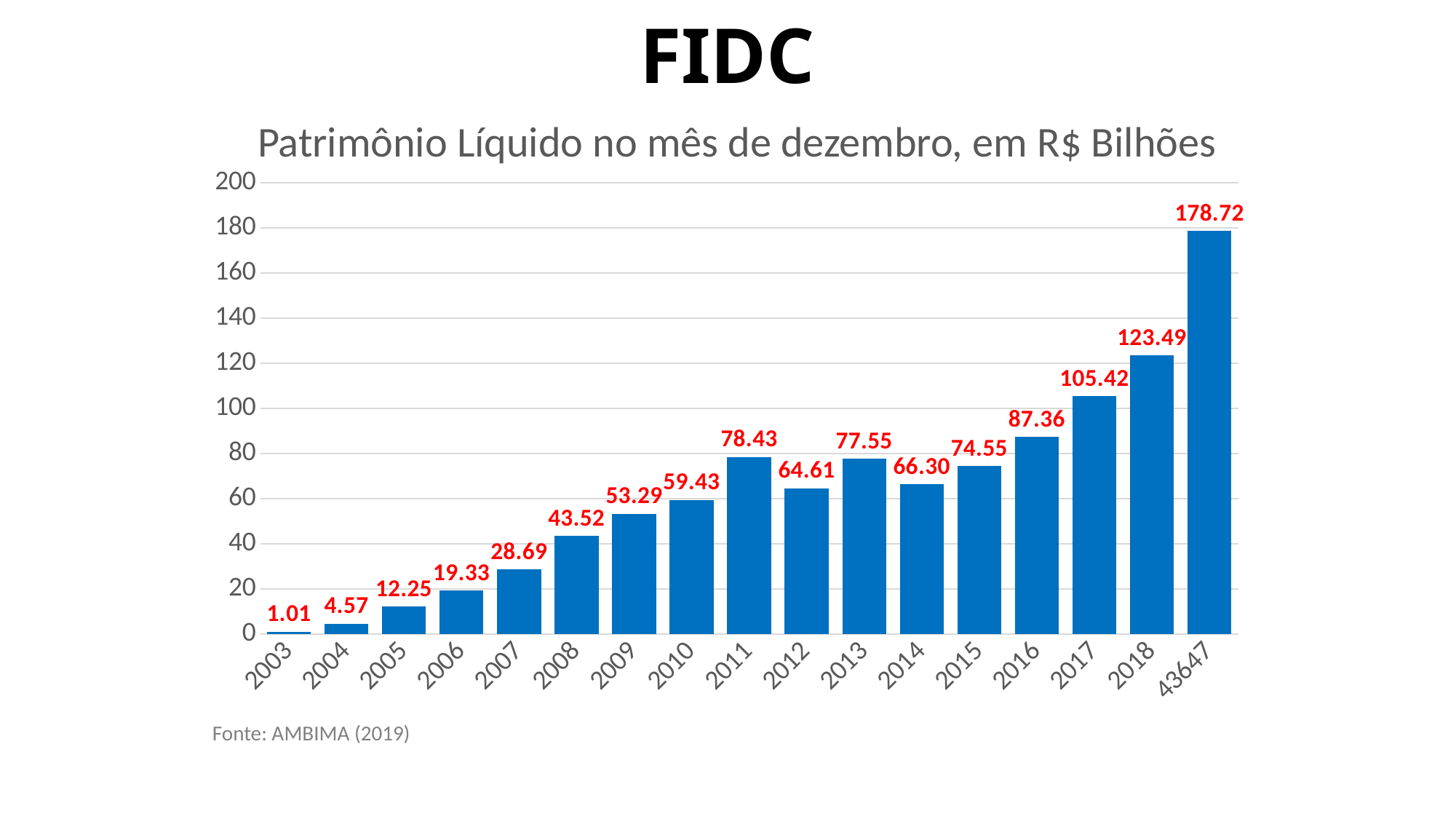
What kind of chart is shown on the slide? bar chart Which category has the highest value? 43647 Is the value for 2017 greater or less than 100? greater What is the value for 2011? 78.43 What is the value for 2016? 87.36 What is the value for 2008? 43.52 How many bars are shown in the chart? 17 From 2015 to the last bar, do the values rise or fall? rise Which is larger, the value for 2014 or the value for 2015? 2015 Which year has the lowest value? 2003 What is the title of the chart? Patrimônio Líquido no mês de dezembro, em R$ Bilhões What is the difference between the values for 2018 and 2017? 18.07